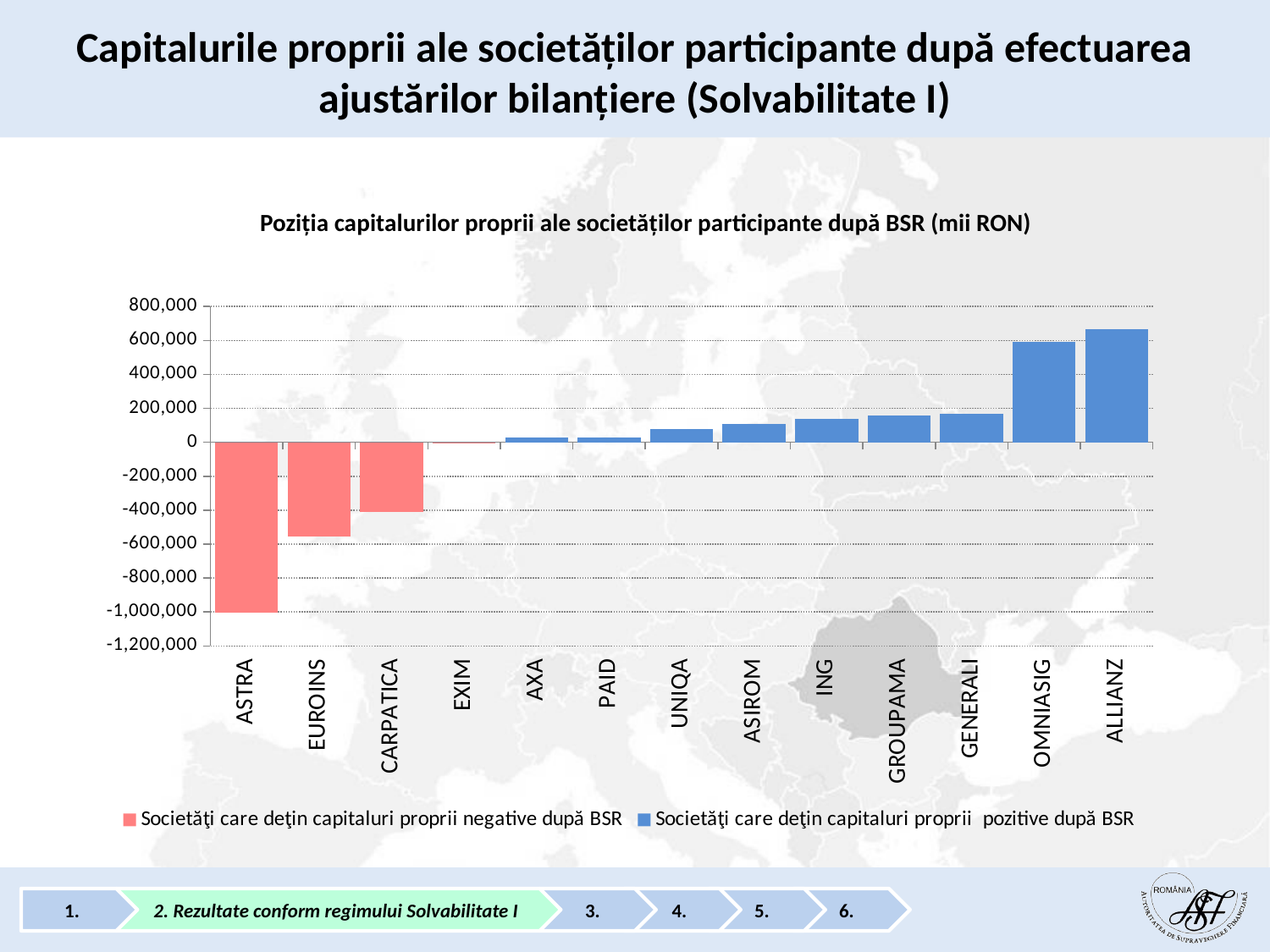
Which company has the highest value in the chart? ALLIANZ Is the value for OMNIASIG greater or less than 400,000? greater Do the values rise or fall moving from left to right along the x axis? rise Is the value for ASTRA greater or less than -800,000? less Which has the larger value, OMNIASIG or GENERALI? OMNIASIG What kind of chart is shown on the slide? bar chart Is the value for EUROINS greater or less than -400,000? less Which company has the lowest value in the chart? ASTRA How many companies are shown on the x axis of the chart? 13 What colour are the bars for companies with negative equity after BSR? red How many series does the legend list? 2